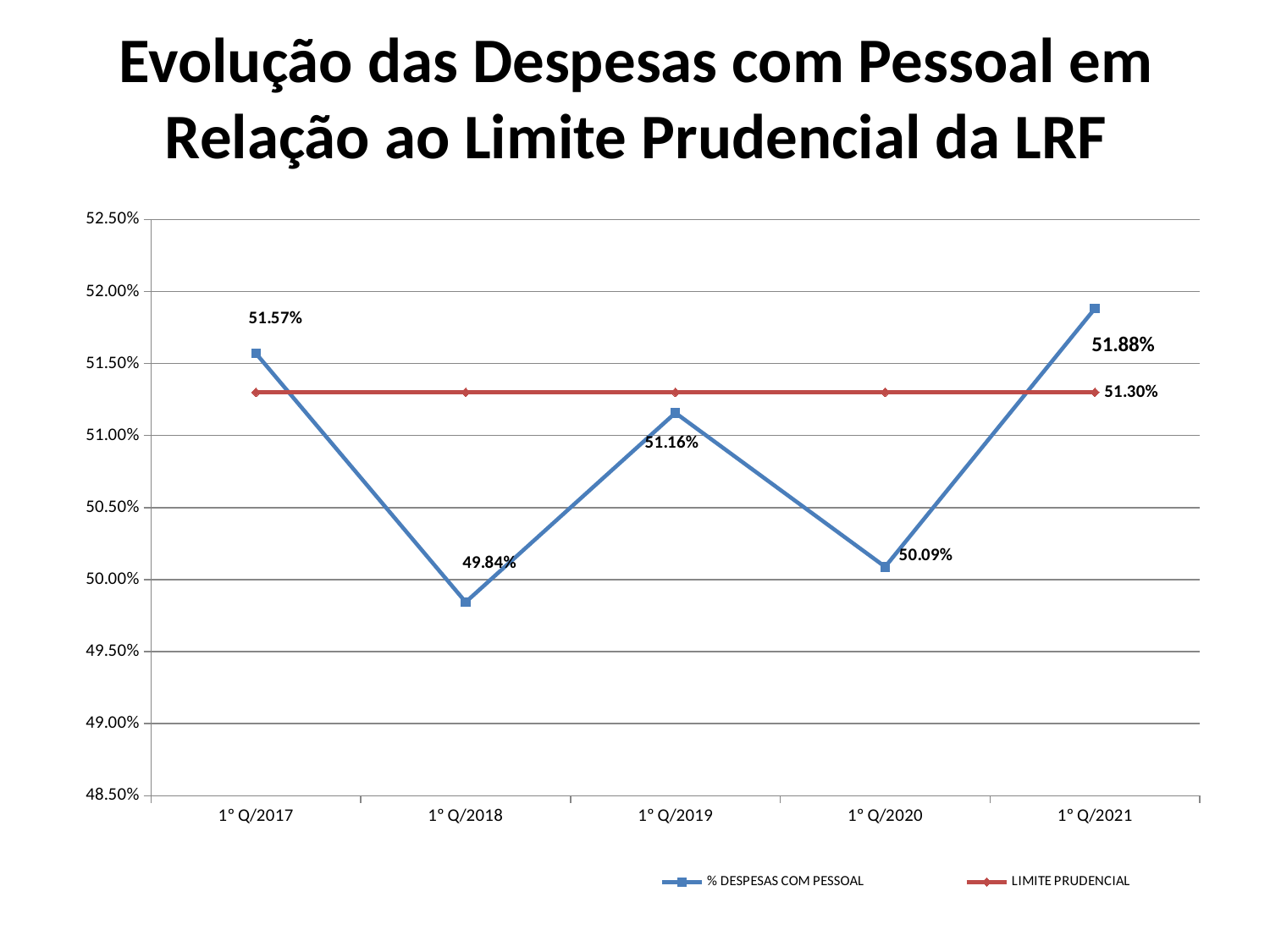
Is the value of % DESPESAS COM PESSOAL for 1° Q/2018 greater or less than 50.00%? less In which period is % DESPESAS COM PESSOAL highest? 1° Q/2021 Which is larger: % DESPESAS COM PESSOAL in 1° Q/2019 or in 1° Q/2020? 1° Q/2019 What is the difference between % DESPESAS COM PESSOAL in 1° Q/2021 and 1° Q/2020? 1.79% What is the value of % DESPESAS COM PESSOAL for 1° Q/2017? 51.57% How many series does the legend list? 2 What is the value of the LIMITE PRUDENCIAL line? 51.30% What is the value of % DESPESAS COM PESSOAL for 1° Q/2021? 51.88% How many periods are shown on the x axis? 5 In which period is % DESPESAS COM PESSOAL lowest? 1° Q/2018 What is the value of % DESPESAS COM PESSOAL for 1° Q/2018? 49.84% What kind of chart is shown on the slide? line chart